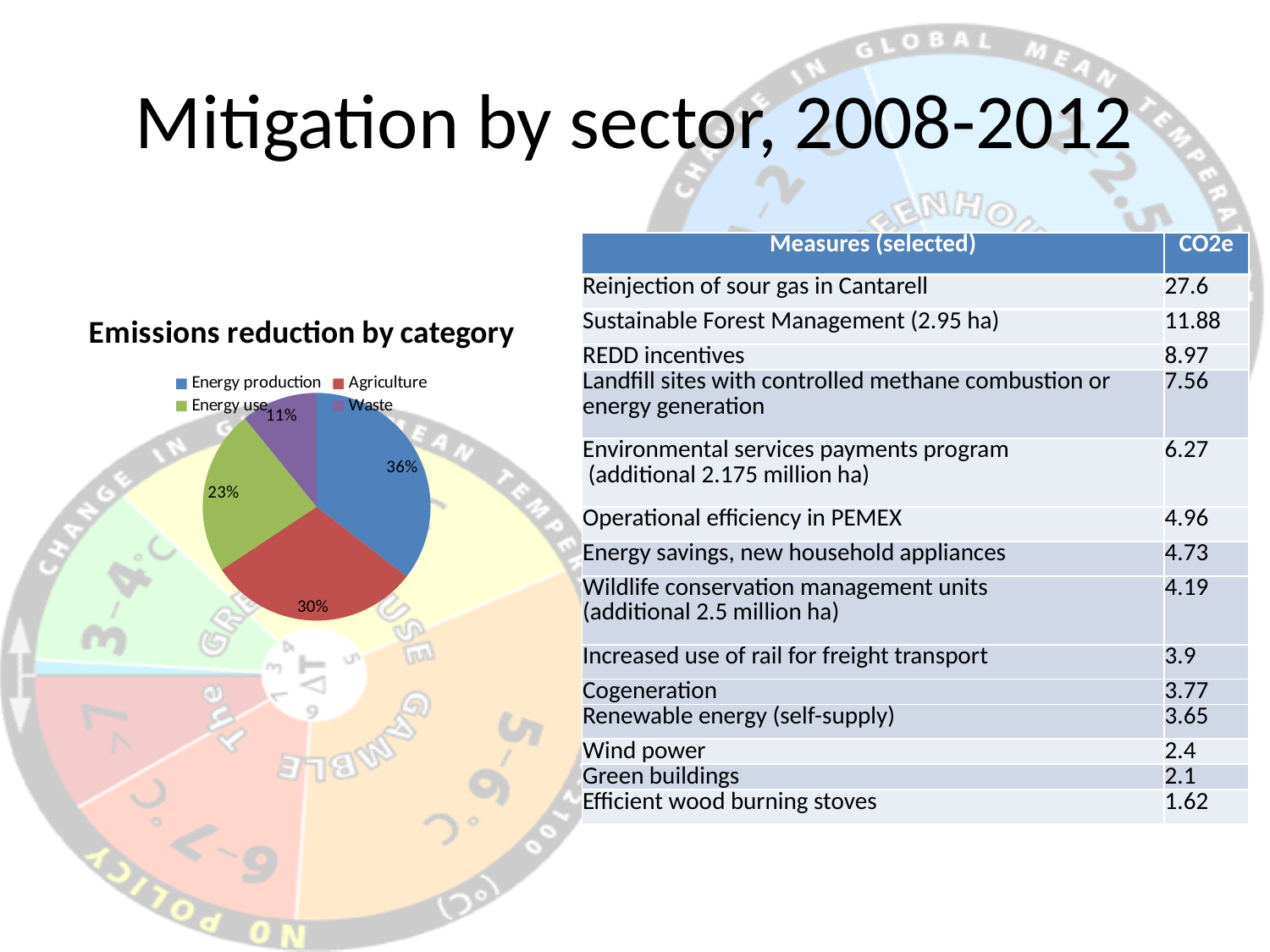
In the "Emissions reduction by category" pie chart, what share does Energy use have? 23% What type of chart is shown under the title "Emissions reduction by category"? pie chart How many categories does the "Emissions reduction by category" pie chart show? 4 Which category has the largest slice in the "Emissions reduction by category" pie chart? Energy production In the "Emissions reduction by category" pie chart, what share does Agriculture have? 30% In the "Emissions reduction by category" pie chart, what share does Waste have? 11% In the "Emissions reduction by category" pie chart, what is the difference in percentage points between Energy production and Waste? 25 What is the title of the pie chart on the slide? Emissions reduction by category In the "Emissions reduction by category" pie chart, what share does Energy production have? 36% In the "Emissions reduction by category" pie chart, which colour represents Energy use? green Which category has the smallest slice in the "Emissions reduction by category" pie chart? Waste In the "Emissions reduction by category" pie chart, which is larger: Agriculture or Energy use? Agriculture